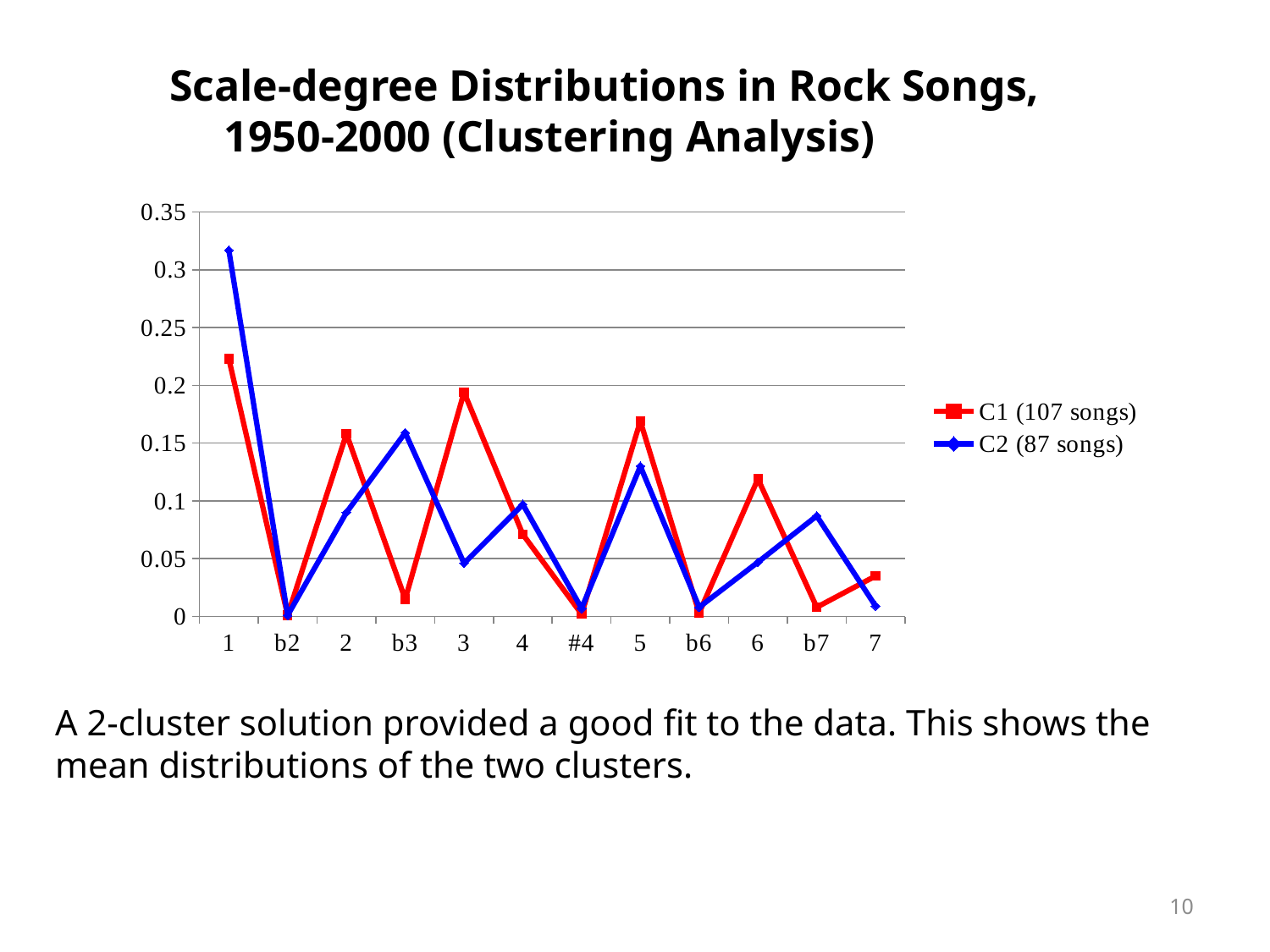
At which scale degree does the C2 (87 songs) series reach its highest value? 1 At scale degree b3, which series has the larger value, C1 or C2? C2 (87 songs) Is the value for C1 (107 songs) at scale degree 6 greater or less than 0.1? greater How many scale-degree categories are shown on the x axis? 12 At scale degree 3, which series has the larger value, C1 or C2? C1 (107 songs) Is the value for C2 (87 songs) at scale degree 3 greater or less than 0.1? less Is the value for C2 (87 songs) at scale degree 1 greater or less than 0.3? greater At scale degree 1, which series has the larger value, C1 or C2? C2 (87 songs) At which scale degree does the C1 (107 songs) series reach its highest value? 1 How many series does the legend list? 2 What kind of chart is shown on the slide? line chart What are the two series named in the legend? C1 (107 songs) and C2 (87 songs)